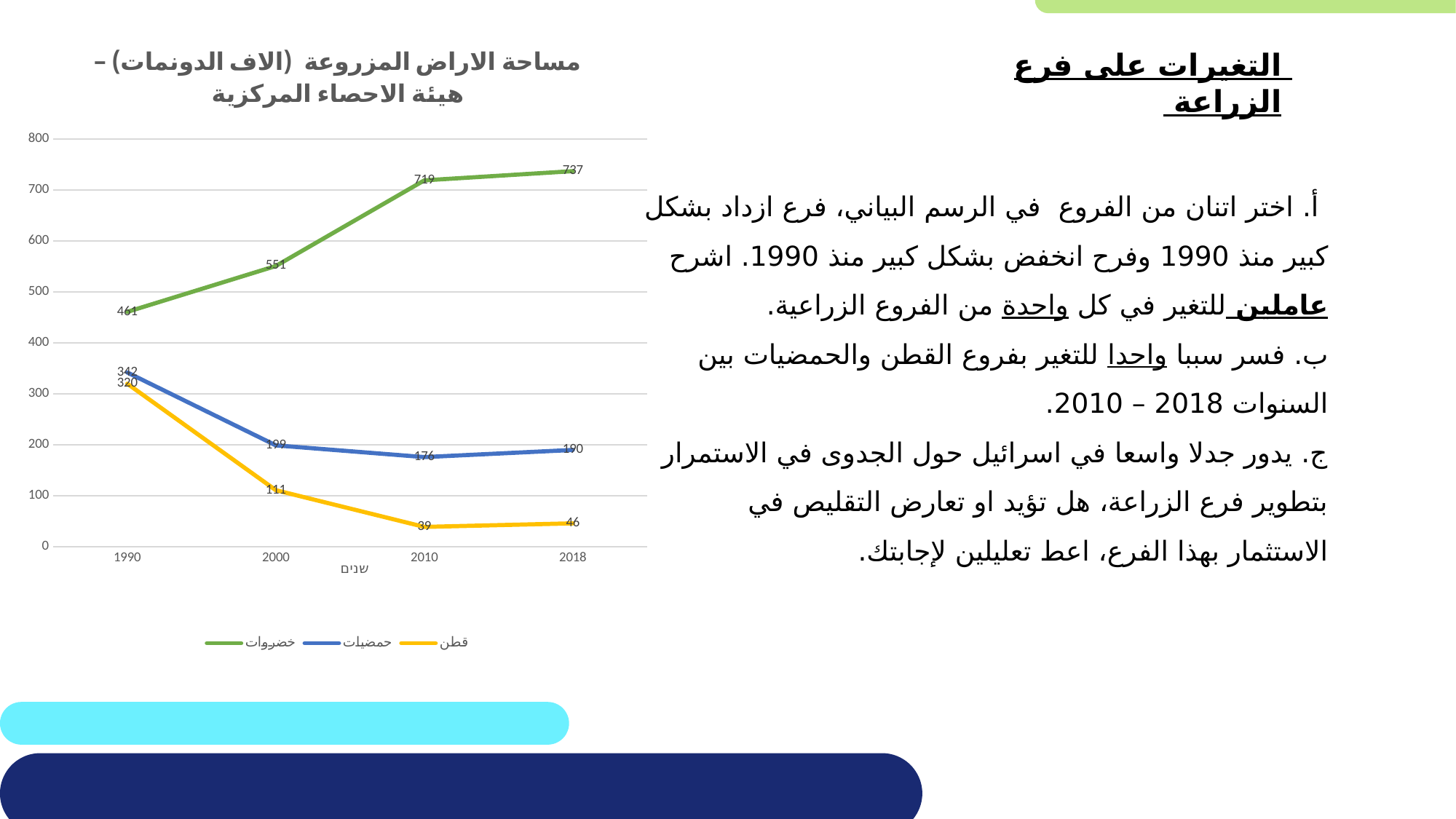
What is the value for حمضيات in 2000? 199 How many series does the chart legend list? 3 Which series has the larger value in 1990, حمضيات or قطن? حمضيات What kind of chart is shown on the slide? Line chart In which year is the value for خضروات highest? 2018 In which year is the value for قطن lowest? 2010 Does the value for خضروات rise or fall from 1990 to 2018? Rise Which series is drawn in green? خضروات What is the value for خضروات in 2018? 737 What is the value for قطن in 2010? 39 What is the difference between the خضروات value in 2018 and its value in 1990? 276 How many years are plotted along the x axis? 4